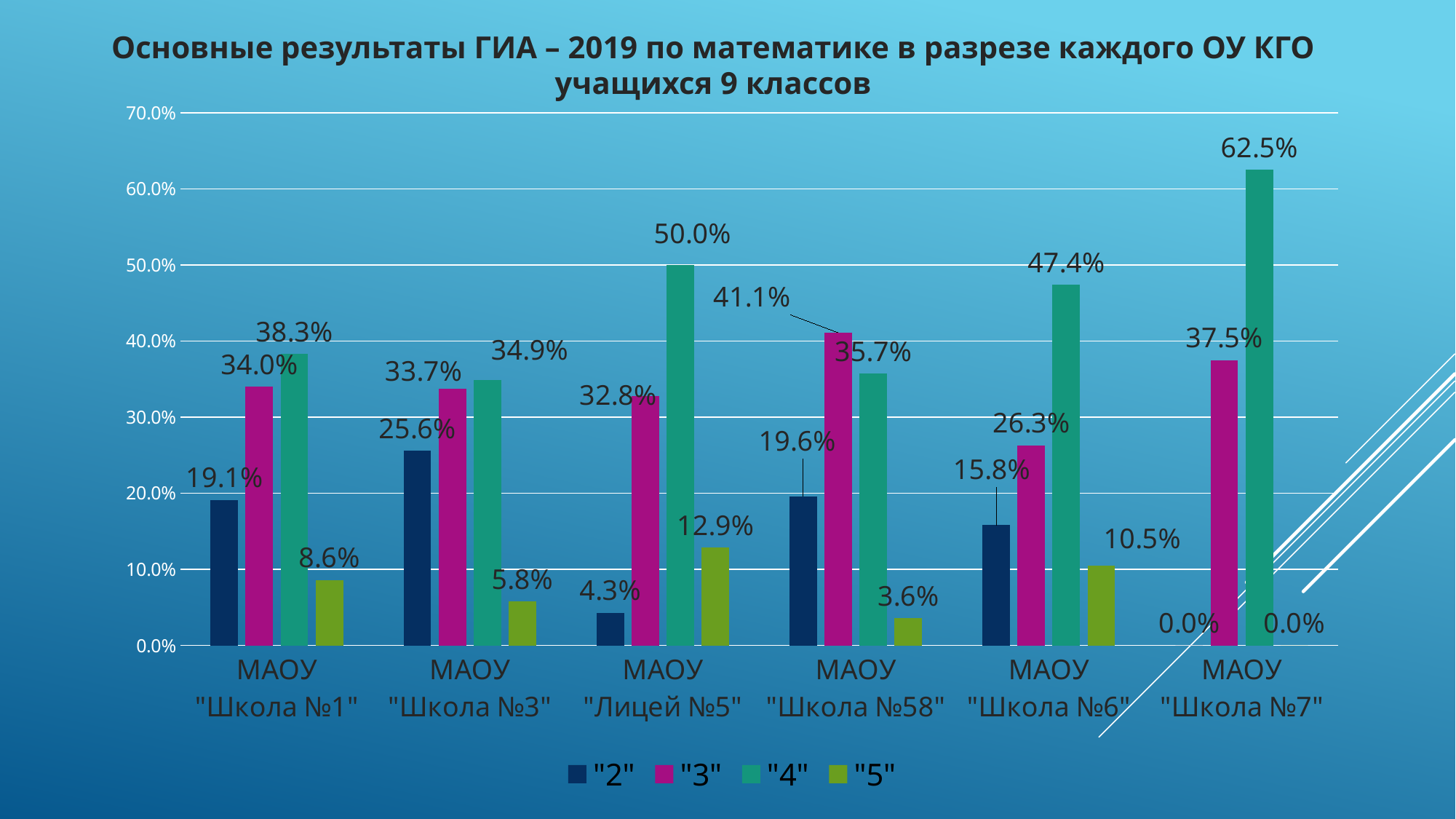
How many schools (categories) are shown on the x axis? 6 What is the difference between the "4" value and the "3" value for МАОУ "Школа №7"? 25.0% Which is larger for МАОУ "Школа №58": the "3" value or the "4" value? "3" Which school has the lowest value in the "2" series? МАОУ "Школа №7" What is the value of the "4" series for МАОУ "Лицей №5"? 50.0% What type of chart is shown on the slide? bar chart Is the "4" value for МАОУ "Школа №6" greater or less than 40.0%? greater What colour are the bars for the "3" series? magenta (pink) What is the value of the "2" series for МАОУ "Школа №3"? 25.6% What is the value of the "5" series for МАОУ "Школа №58"? 3.6% Which school has the highest value in the "4" series? МАОУ "Школа №7" How many series does the legend list? 4